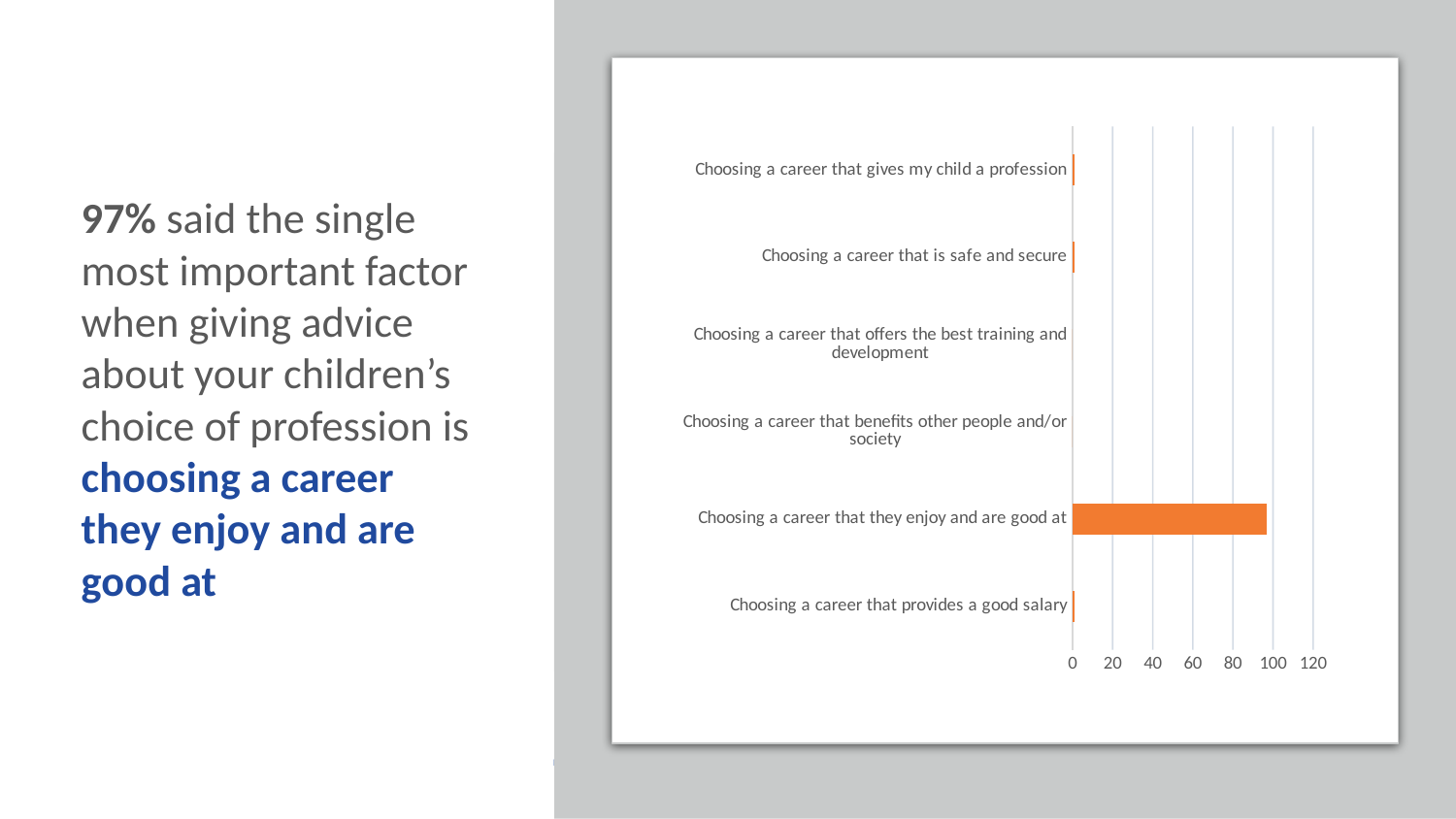
What kind of chart is shown on the slide? bar chart Which is larger: the value for "Choosing a career that they enjoy and are good at" or the value for "Choosing a career that provides a good salary"? Choosing a career that they enjoy and are good at Is the value for "Choosing a career that is safe and secure" greater or less than 20? less Is the value for "Choosing a career that gives my child a profession" greater or less than 40? less How many categories are shown on the chart? 6 Is the value for "Choosing a career that they enjoy and are good at" greater or less than 80? greater What is the highest value shown on the chart's horizontal axis? 120 Which is larger: the value for "Choosing a career that benefits other people and/or society" or the value for "Choosing a career that they enjoy and are good at"? Choosing a career that they enjoy and are good at What colour is the bar for "Choosing a career that they enjoy and are good at"? orange Which category has the highest value on the chart? Choosing a career that they enjoy and are good at